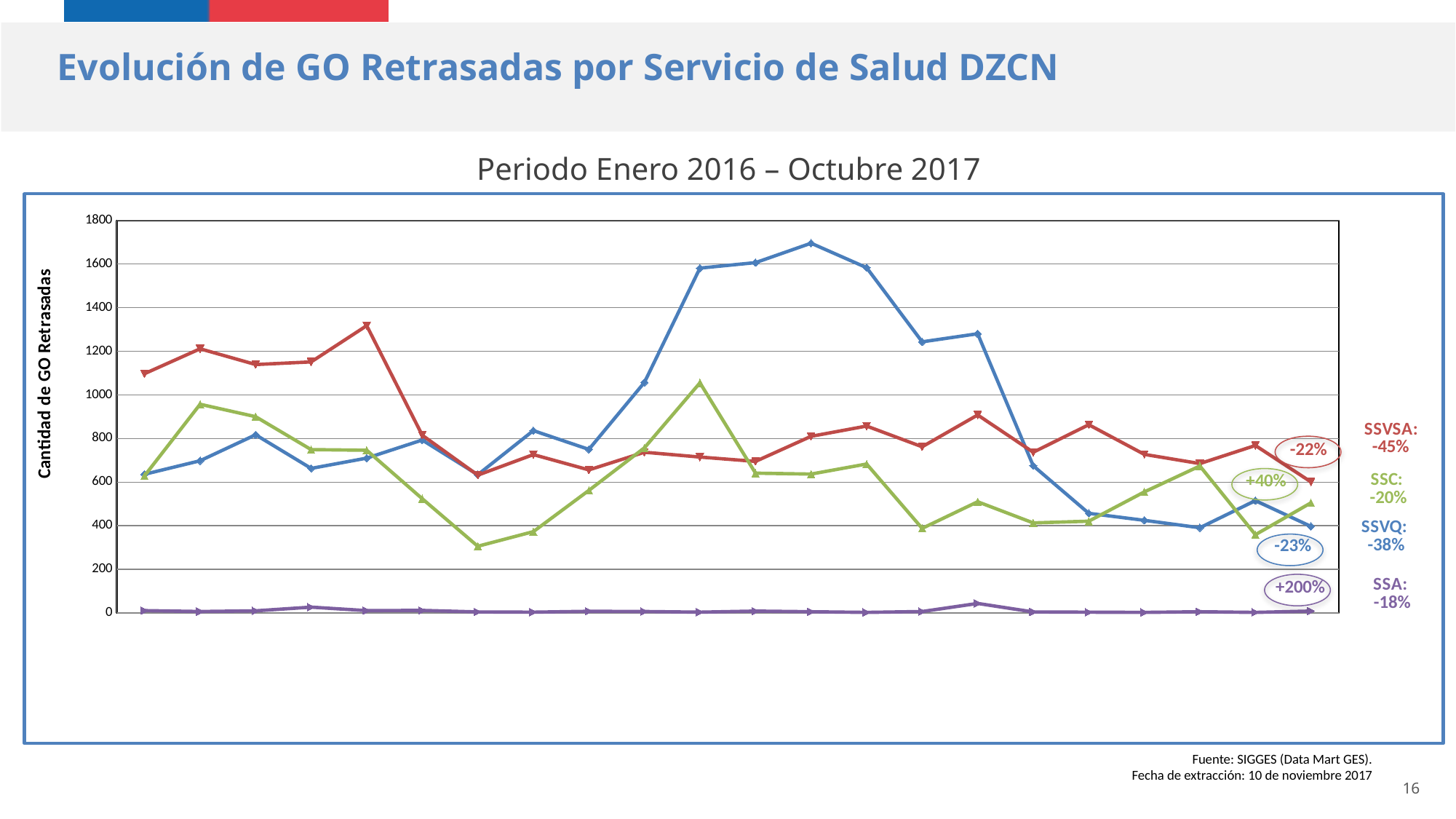
What percentage is shown in the purple oval next to the SSA line? +200% Is the lowest value of the SSC (green) line greater or less than 400? less What is the label of the vertical axis? Cantidad de GO Retrasadas Is the first value of the SSVSA (red) line greater or less than 1000? greater What percentage change is printed for SSVQ on the right of the chart? -38% Which service's line stays lowest across the whole period? SSA What kind of chart is shown on the slide? line chart What percentage change is printed for SSVSA on the right of the chart? -45% How many health services (series) are plotted on the chart? 4 Which service's line reaches the highest value on the chart? SSVQ Is the peak value of the SSVQ (blue) line greater or less than 1600? greater How many monthly data points does each line have? 22